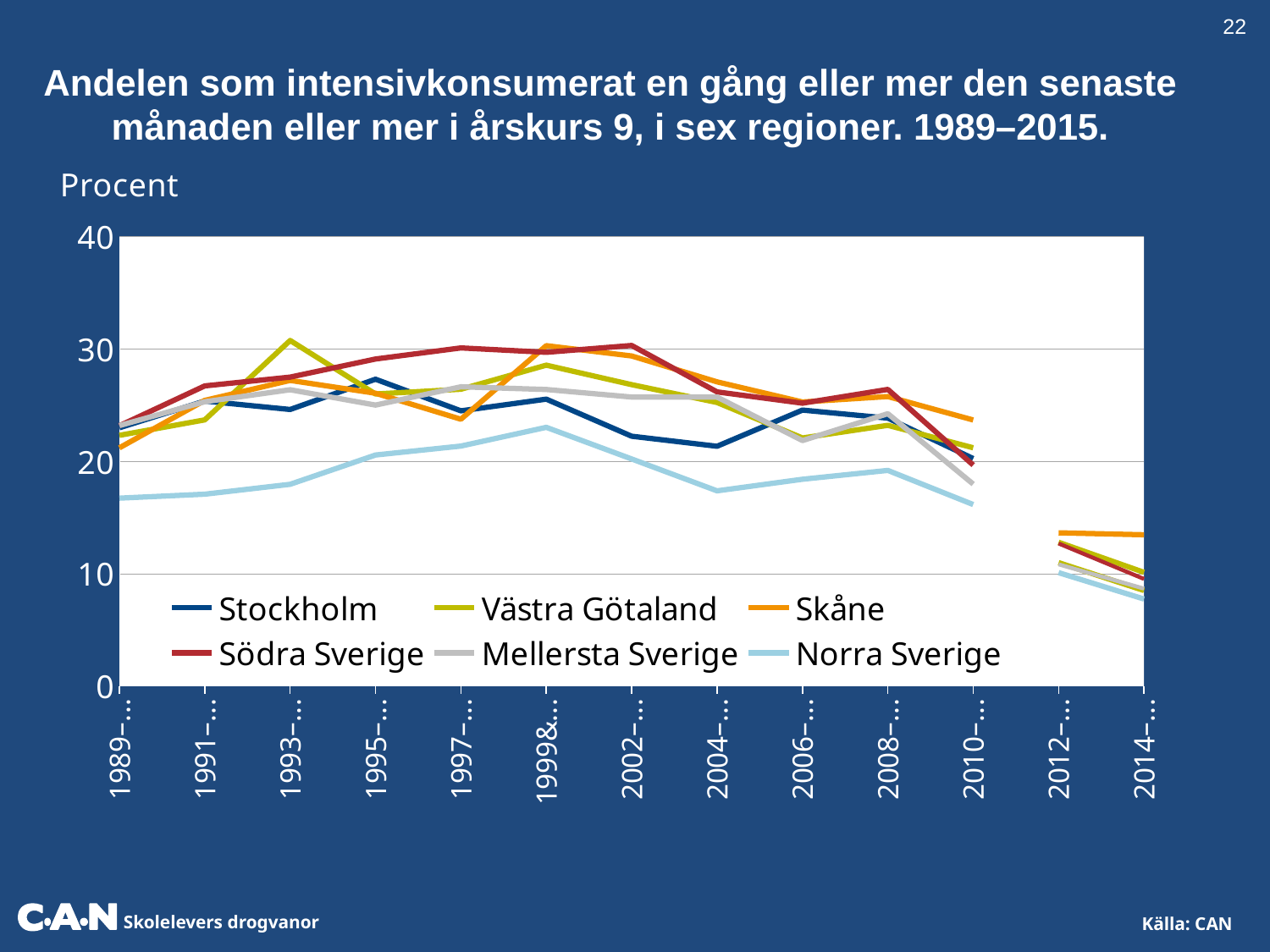
Is the value for Skåne at the 2012 point greater or less than 10? greater What kind of chart is shown on the slide? Line chart Is the value for Norra Sverige at the last point (2014) greater or less than 10? less At the 1989 point, which is larger: Södra Sverige or Norra Sverige? Södra Sverige Which region has the lowest value at the first point (1989)? Norra Sverige Which regions are listed in the chart legend? Stockholm, Västra Götaland, Skåne, Södra Sverige, Mellersta Sverige, Norra Sverige What is the label shown above the vertical axis of the chart? Procent Do the values for Norra Sverige rise or fall from the 2008 point to the 2014 point? fall Which region has the highest value at the last point (2014)? Skåne How many time points are labelled along the x axis? 13 How many series does the legend list? 6 Is the value for Norra Sverige at the first point (1989) greater or less than 20? less